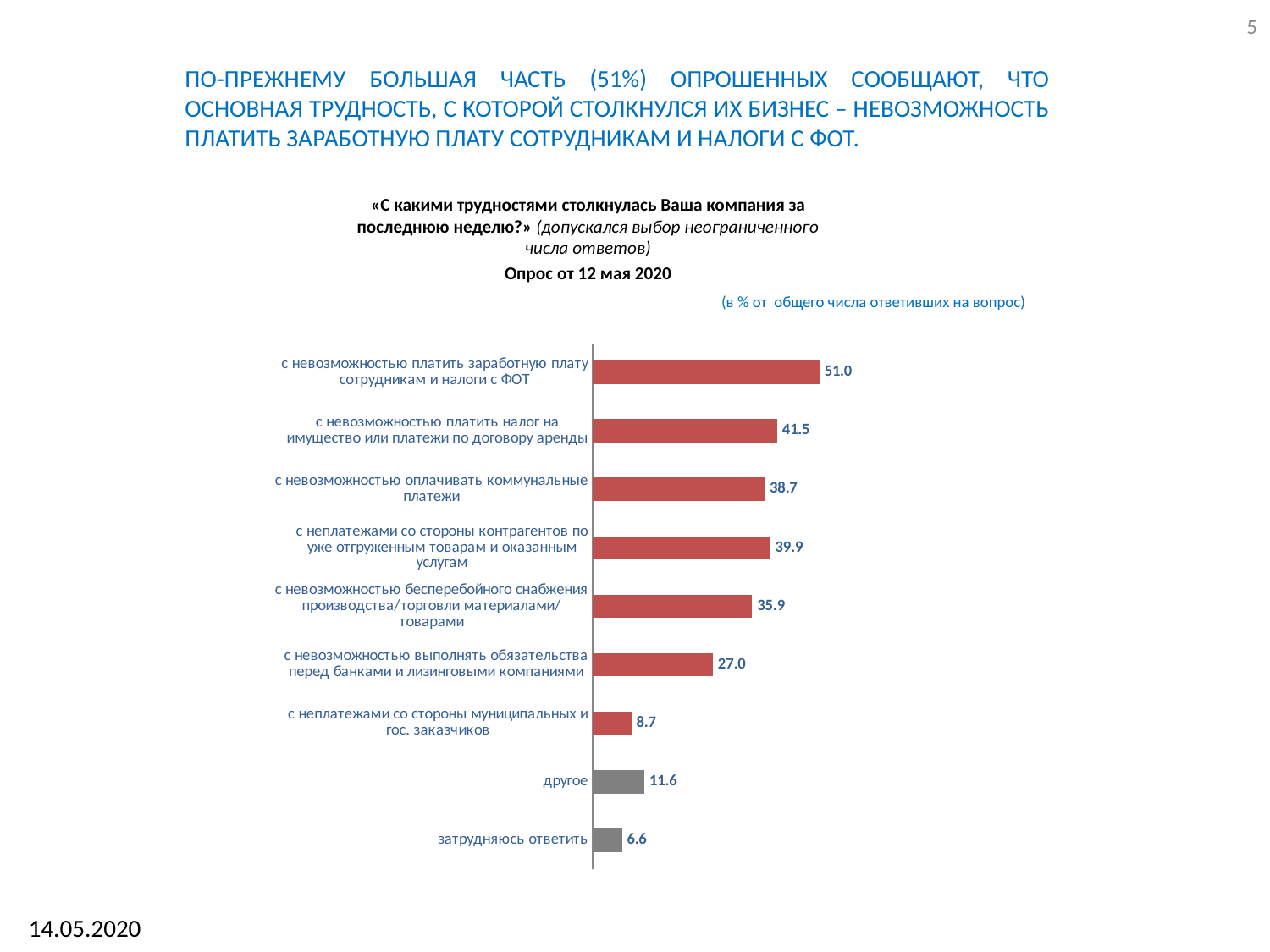
Which category has the lowest value? затрудняюсь ответить What is the difference between the values for «с невозможностью платить заработную плату сотрудникам и налоги с ФОТ» and «с невозможностью платить налог на имущество или платежи по договору аренды»? 9.5 What is the difference between the values for «с невозможностью бесперебойного снабжения производства/торговли материалами/товарами» and «затрудняюсь ответить»? 29.3 What kind of chart is shown on the slide? bar chart What value is shown for «другое»? 11.6 What value is shown for «с невозможностью выполнять обязательства перед банками и лизинговыми компаниями»? 27.0 Which category has the highest value? с невозможностью платить заработную плату сотрудникам и налоги с ФОТ How many categories are shown in the chart? 9 What date of the survey is stated above the chart? 12 мая 2020 Which is larger: the value for «с неплатежами со стороны контрагентов по уже отгруженным товарам и оказанным услугам» or for «с невозможностью оплачивать коммунальные платежи»? с неплатежами со стороны контрагентов по уже отгруженным товарам и оказанным услугам Which is larger: the value for «другое» or for «с неплатежами со стороны муниципальных и гос. заказчиков»? другое What value is shown for «с невозможностью платить заработную плату сотрудникам и налоги с ФОТ»? 51.0